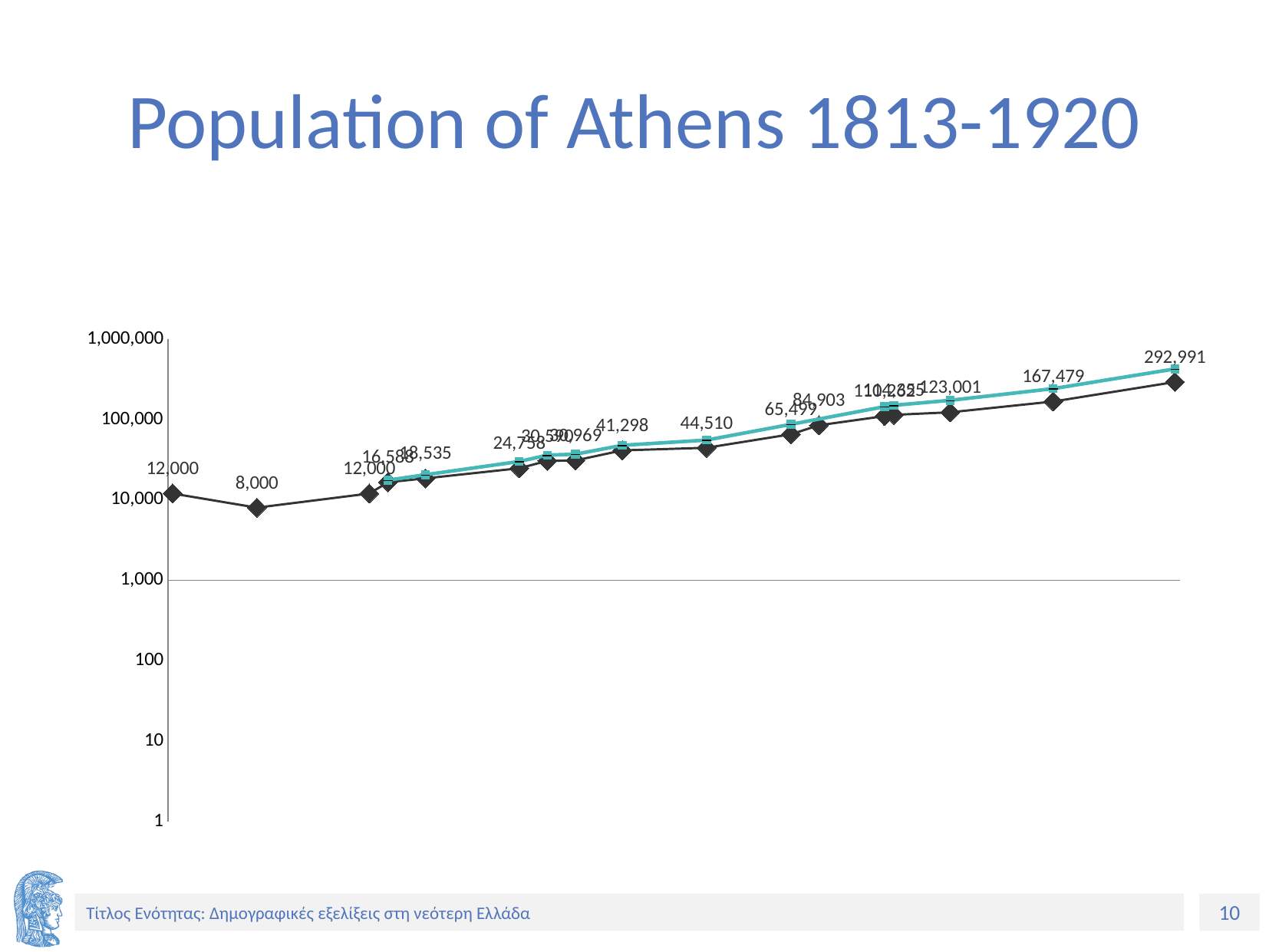
What kind of chart is shown on the slide? line chart What is the difference between the last labelled value (292,991) and the first labelled value (12,000)? 280,991 How many lines are plotted on the chart? 2 Is the lowest point on the chart greater or less than 10,000? less What is the value labelled at the first (leftmost) point of the chart? 12,000 What is the value labelled at the last (rightmost) point of the chart? 292,991 Which labelled value is larger, 44,510 or 41,298? 44,510 What is the highest labelled value on the chart? 292,991 What is the lowest labelled value on the chart? 8,000 What is the title of the slide's chart? Population of Athens 1813-1920 What is the difference between the labelled values 167,479 and 123,001? 44,478 What is the value labelled at the second point from the left? 8,000